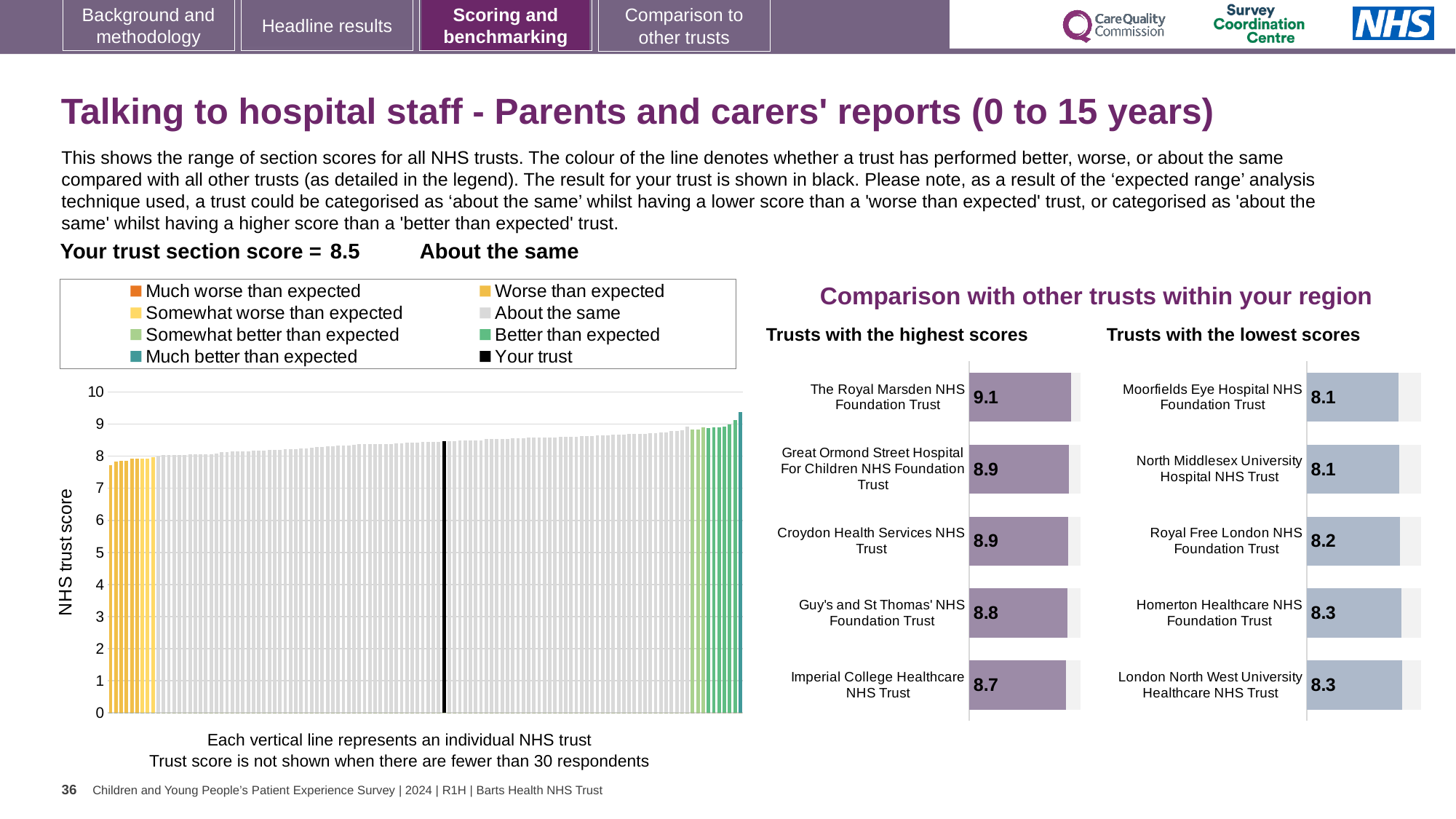
In the 'Trusts with the highest scores' chart, which has the larger score: Croydon Health Services NHS Trust or Guy's and St Thomas' NHS Foundation Trust? Croydon Health Services NHS Trust In the 'Trusts with the highest scores' chart, which trust has the lowest score? Imperial College Healthcare NHS Trust In the 'Trusts with the highest scores' chart, which trust has the highest score? The Royal Marsden NHS Foundation Trust In the 'Trusts with the highest scores' chart, what is the score for The Royal Marsden NHS Foundation Trust? 9.1 In the 'Trusts with the highest scores' chart, what is the score for Imperial College Healthcare NHS Trust? 8.7 What kind of chart is the large chart on the left showing NHS trust scores? Bar chart In the 'Trusts with the lowest scores' chart, what is the difference between the scores of Homerton Healthcare NHS Foundation Trust and Moorfields Eye Hospital NHS Foundation Trust? 0.2 What is the y-axis label of the large chart on the left? NHS trust score How many trusts are shown in the 'Trusts with the lowest scores' chart? 5 In the 'Trusts with the highest scores' chart, what is the difference between the scores of The Royal Marsden NHS Foundation Trust and Imperial College Healthcare NHS Trust? 0.4 How many entries does the legend above the left chart list? 8 In the 'Trusts with the lowest scores' chart, what is the score for Royal Free London NHS Foundation Trust? 8.2